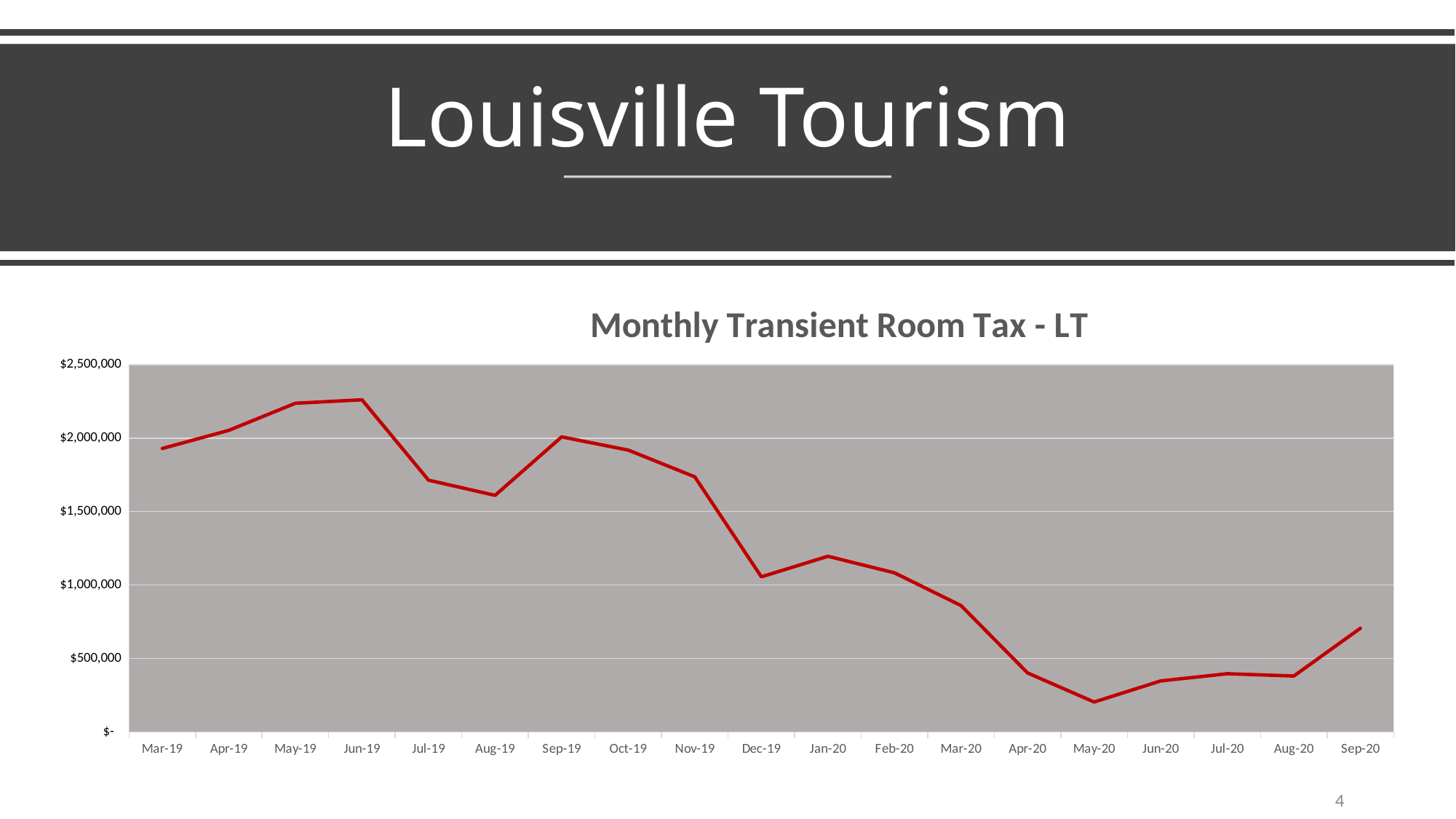
What kind of chart is shown on the slide? line chart Which month has the lowest value on the chart? May-20 What is the title of the chart? Monthly Transient Room Tax - LT Is the value for Apr-20 greater or less than $500,000? less Is the value for Sep-20 greater or less than $500,000? greater Is the value for Jul-19 greater or less than $1,500,000? greater Overall, do the values rise or fall from Mar-19 to Sep-20? fall How many months are plotted on the x axis of the chart? 19 Which is larger, the value for Sep-19 or the value for Dec-19? Sep-19 What colour is the line on the chart? red